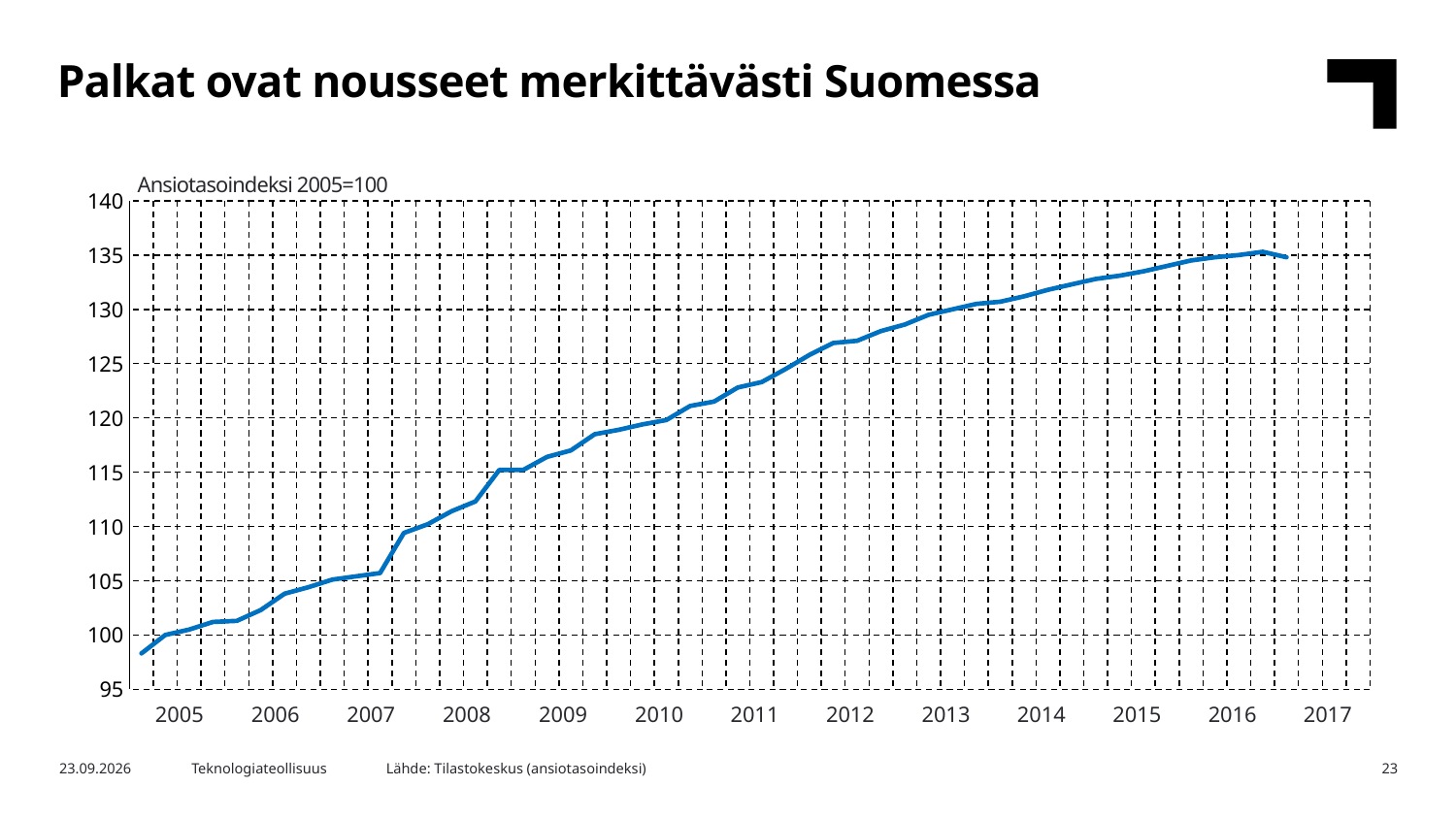
Do the values generally rise or fall from 2005 to 2016? rise Is the value at the start of 2012 greater or less than 125? greater What kind of chart is shown on the slide? line chart Is the value at the start of 2009 greater or less than 120? less What is the title of the chart? Ansiotasoindeksi 2005=100 Is the value at the start of 2015 greater or less than 135? less In which year does the line reach its highest value? 2016 How many year labels are shown on the x axis? 13 In which year does the line reach its lowest value? 2005